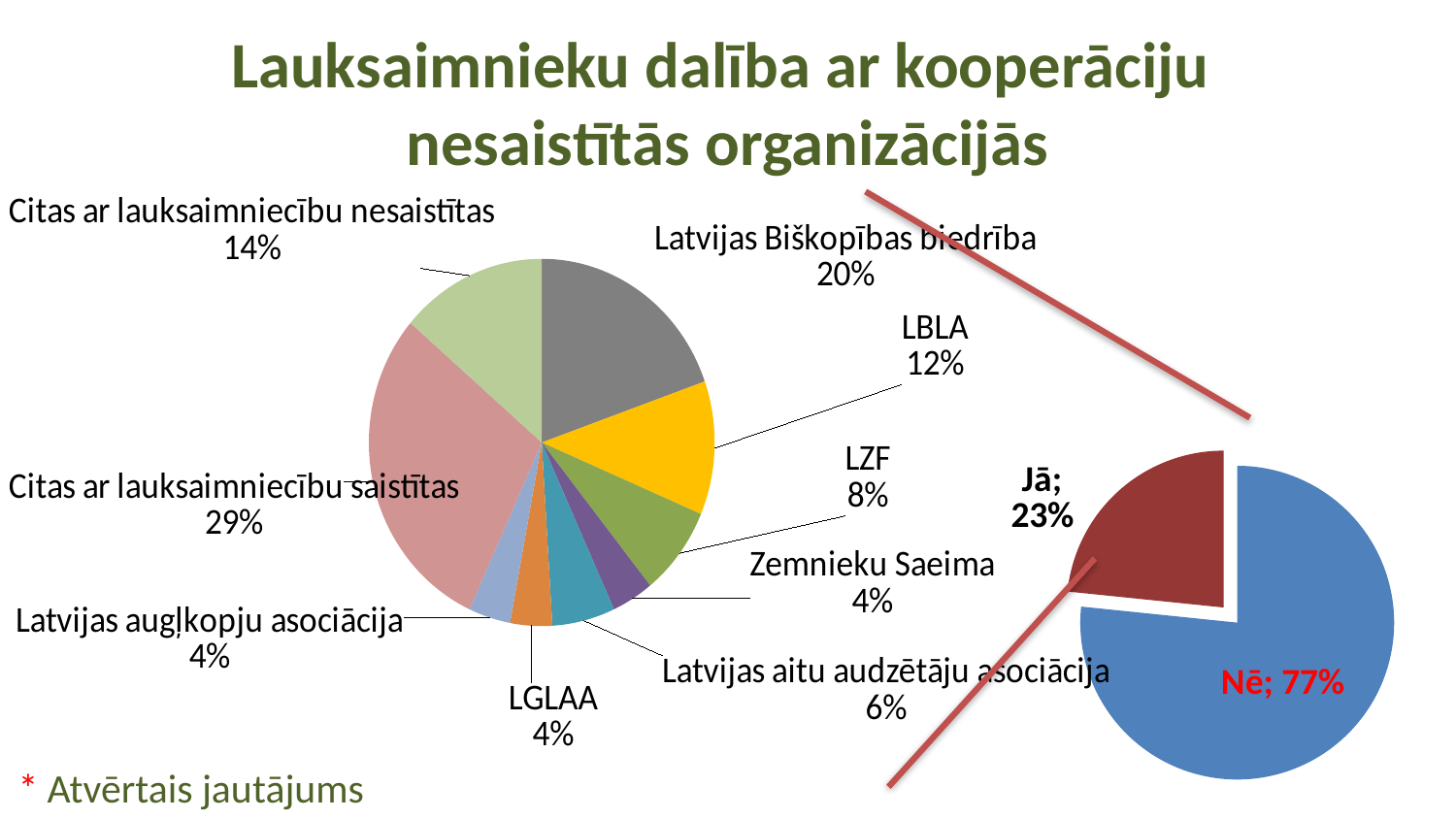
In the small pie chart on the right, what share does Nē have? 77% In the large pie chart on the left, what is the difference between the shares of Citas ar lauksaimniecību saistītas and Citas ar lauksaimniecību nesaistītas? 15% In the small pie chart on the right, what is the difference between the shares of Nē and Jā? 54% What type of chart is the large chart on the left? Pie chart In the large pie chart on the left, which is larger: the share of LZF or the share of LBLA? LBLA How many categories are shown in the large pie chart on the left? 9 What is the title of the slide? Lauksaimnieku dalība ar kooperāciju nesaistītās organizācijās In the small pie chart on the right, what share does Jā have? 23% In the large pie chart on the left, what share does LBLA have? 12% In the large pie chart on the left, which category has the largest share? Citas ar lauksaimniecību saistītas In the large pie chart on the left, what share does Latvijas aitu audzētāju asociācija have? 6% In the large pie chart on the left, what share does Latvijas Biškopības biedrība have? 20%